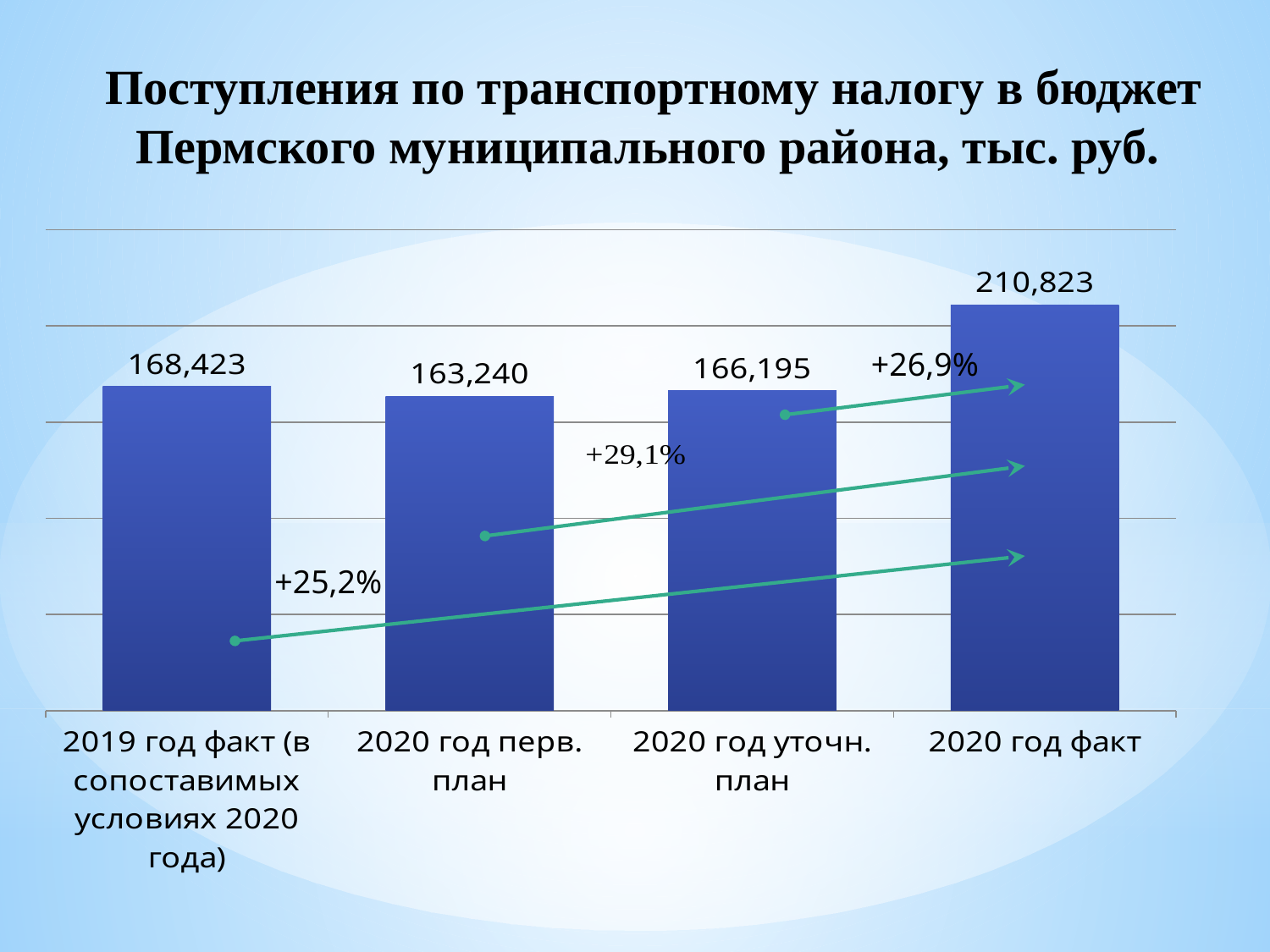
Which category has the lowest value? 2020 год перв. план How many categories are shown in the chart? 4 Which is larger, the value for "2019 год факт (в сопоставимых условиях 2020 года)" or the value for "2020 год уточн. план"? 2019 год факт (в сопоставимых условиях 2020 года) What percentage change is annotated on the arrow from "2020 год перв. план" to "2020 год факт"? +29,1% What is the value for "2020 год уточн. план"? 166,195 What is the value for "2020 год перв. план"? 163,240 What is the difference between the values for "2020 год факт" and "2019 год факт (в сопоставимых условиях 2020 года)"? 42,400 What kind of chart is shown on the slide? Bar chart Which category has the highest value? 2020 год факт What is the value for "2020 год факт"? 210,823 What is the value for "2019 год факт (в сопоставимых условиях 2020 года)"? 168,423 What is the difference between the values for "2020 год уточн. план" and "2020 год перв. план"? 2,955